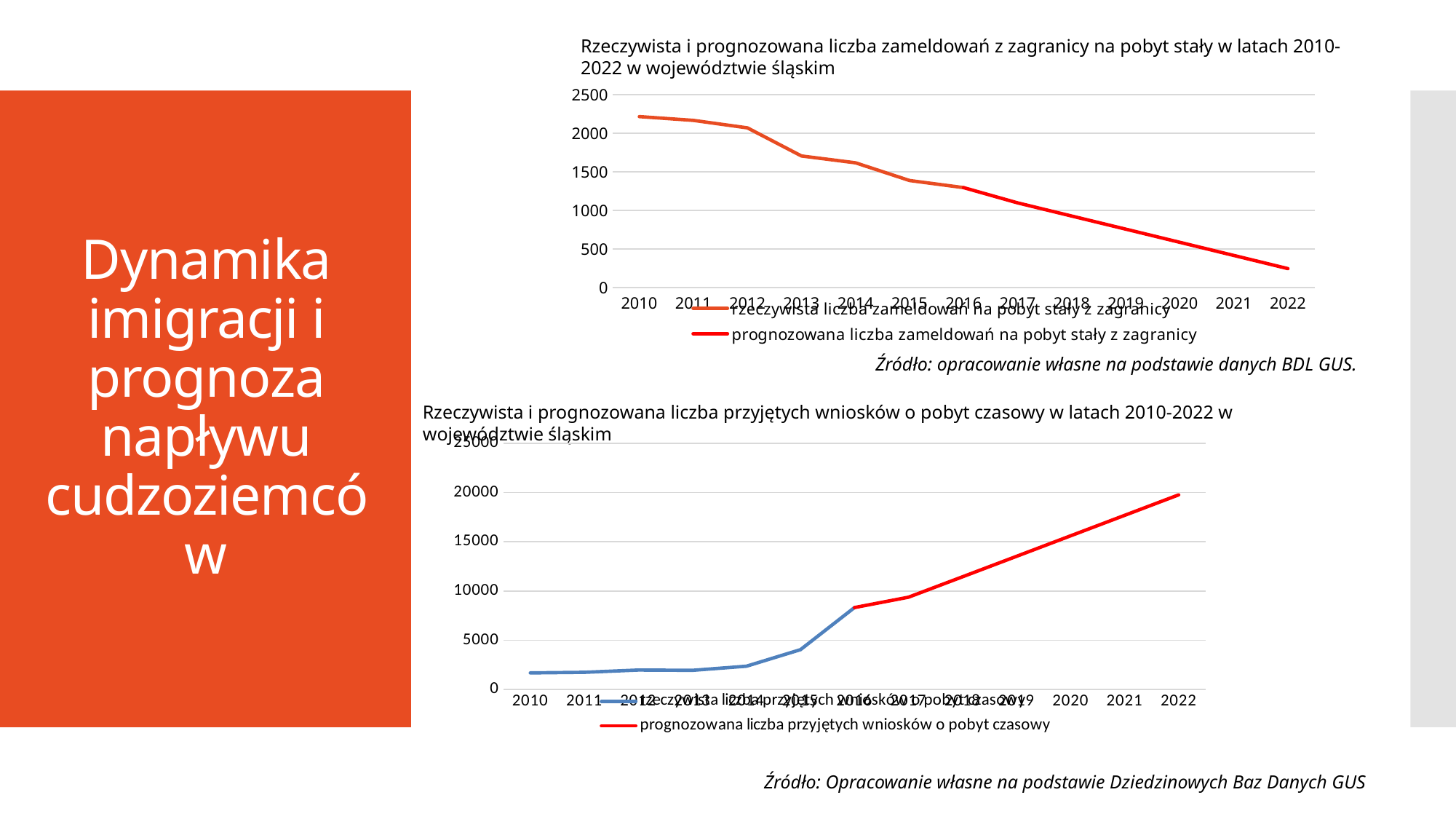
In the top chart (zameldowania na pobyt stały), is the value for 2010 greater or less than 2000? greater In the top chart (zameldowania na pobyt stały), do the values rise or fall from 2010 to 2022? fall In the bottom chart (wnioski o pobyt czasowy), do the values rise or fall from 2010 to 2022? rise In the top chart (zameldowania na pobyt stały), how many series does the legend list? 2 In the bottom chart (wnioski o pobyt czasowy), what colour is the line for the forecast series (prognozowana liczba przyjętych wniosków o pobyt czasowy)? red In the top chart (zameldowania na pobyt stały), how many years are shown on the x axis? 13 In the bottom chart (wnioski o pobyt czasowy), which year has the highest value? 2022 In the top chart (zameldowania na pobyt stały), which year has the highest value? 2010 In the bottom chart (wnioski o pobyt czasowy), is the value for 2022 greater or less than 15000? greater In the top chart (zameldowania na pobyt stały), is the value for 2022 greater or less than 500? less What type of chart is the top chart about zameldowania na pobyt stały? line chart